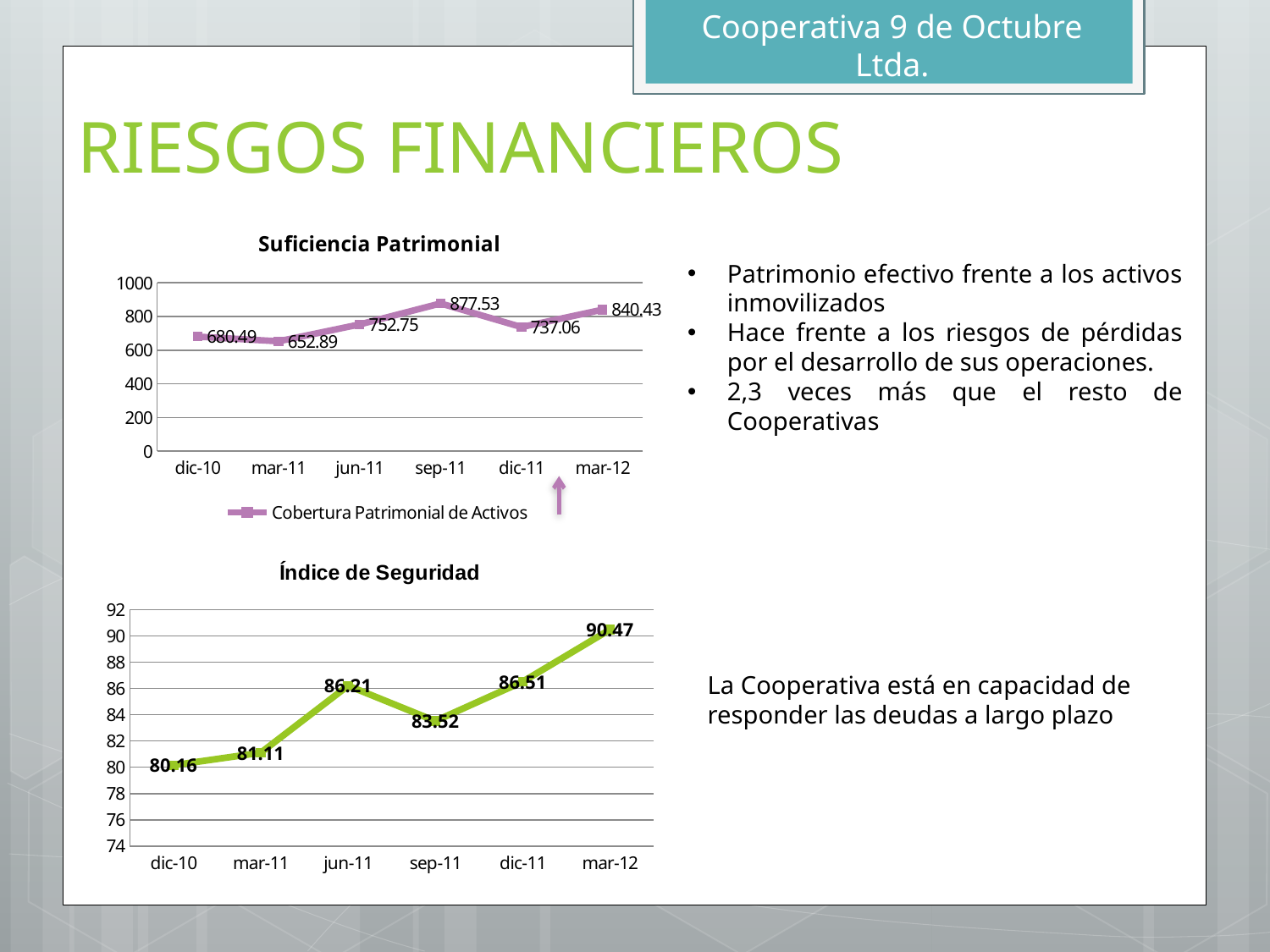
In the 'Suficiencia Patrimonial' chart, what is the difference between the values for mar-12 and dic-11? 103.37 In the 'Índice de Seguridad' chart, what is the difference between the values for mar-12 and dic-10? 10.31 In the 'Suficiencia Patrimonial' chart, is the value for jun-11 greater or less than 800? less In the 'Índice de Seguridad' chart, which period has the highest value? mar-12 In the 'Suficiencia Patrimonial' chart, which period has the lowest value? mar-11 In the 'Suficiencia Patrimonial' chart, what series does the legend list? Cobertura Patrimonial de Activos How many data points are plotted in the 'Índice de Seguridad' chart? 6 What type of chart is the 'Índice de Seguridad' chart? line chart In the 'Índice de Seguridad' chart, what is the value for dic-10? 80.16 In the 'Suficiencia Patrimonial' chart, what is the value for sep-11? 877.53 In the 'Índice de Seguridad' chart, which is larger, the value for jun-11 or the value for sep-11? jun-11 In the 'Índice de Seguridad' chart, is the value for sep-11 greater or less than 84? less